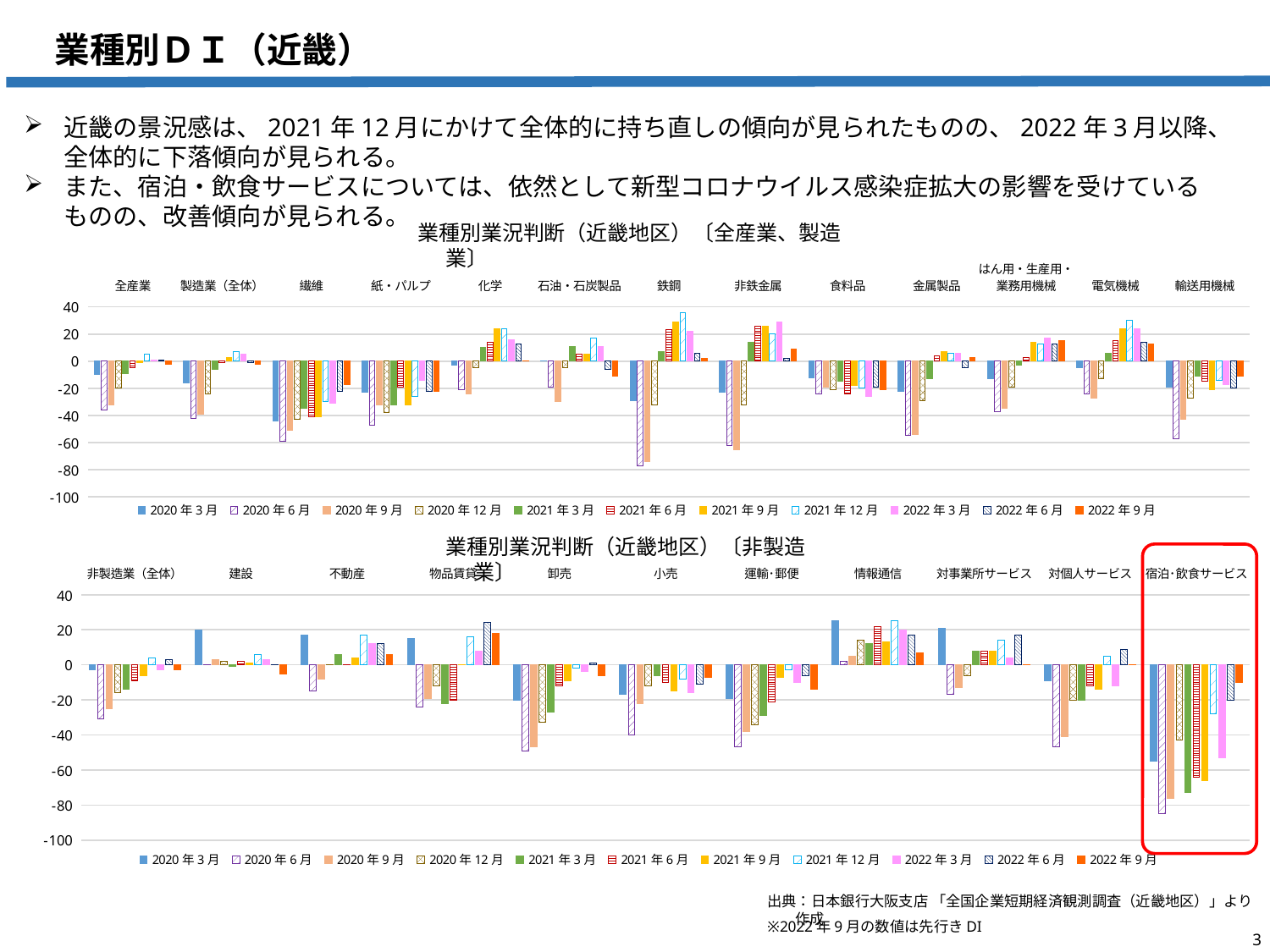
How many series does the legend of the bottom chart 業種別業況判断（近畿地区）〔非製造業〕 list? 11 What is the first series listed in the legend of the top chart 業種別業況判断（近畿地区）〔全産業、製造業〕? 2020年3月 In the top chart 業種別業況判断（近畿地区）〔全産業、製造業〕, which category has the lowest value for 2020年6月? 鉄鋼 In the bottom chart 業種別業況判断（近畿地区）〔非製造業〕, for 宿泊・飲食サービス, which is lower: the value for 2020年6月 or the value for 2022年9月? 2020年6月 How many industry categories are shown on the x axis of the bottom chart 業種別業況判断（近畿地区）〔非製造業〕? 11 In the bottom chart 業種別業況判断（近畿地区）〔非製造業〕, is the value for 情報通信 in 2020年3月 greater or less than 20? greater In the bottom chart 業種別業況判断（近畿地区）〔非製造業〕, which category has the lowest value for 2020年6月? 宿泊・飲食サービス In the top chart 業種別業況判断（近畿地区）〔全産業、製造業〕, is the value for 鉄鋼 in 2020年6月 greater or less than -60? less In the bottom chart 業種別業況判断（近畿地区）〔非製造業〕, which category is highlighted with a red box? 宿泊・飲食サービス In the bottom chart 業種別業況判断（近畿地区）〔非製造業〕, is the value for 宿泊・飲食サービス in 2020年6月 greater or less than -80? less What kind of chart is the top chart titled 業種別業況判断（近畿地区）〔全産業、製造業〕? bar chart How many industry categories are shown on the x axis of the top chart 業種別業況判断（近畿地区）〔全産業、製造業〕? 13